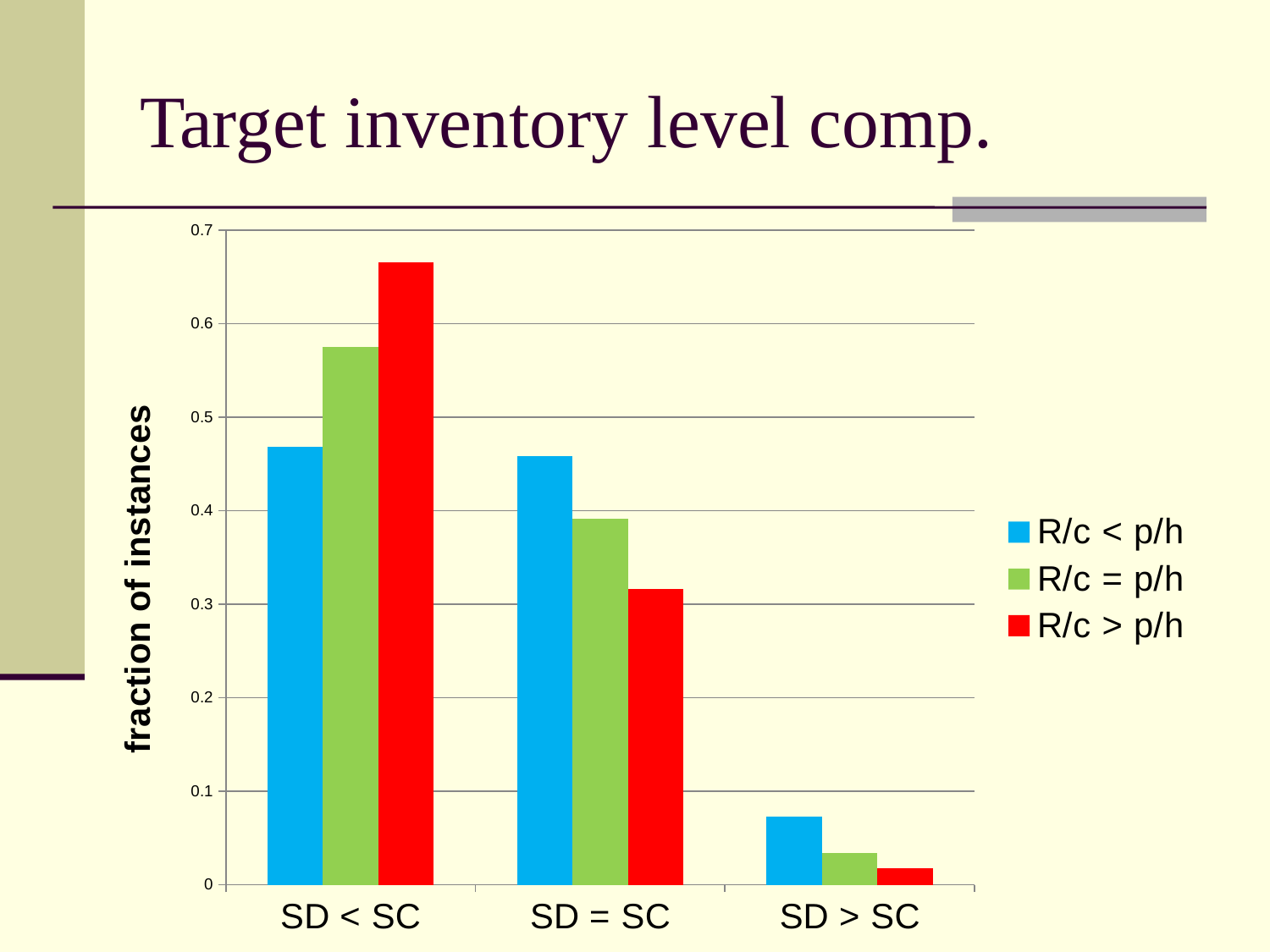
Which series has the highest bar in the SD = SC category? R/c < p/h Which series has the highest bar in the SD < SC category? R/c > p/h Is the value for R/c < p/h in the SD < SC category greater or less than 0.5? less How many series does the legend list? 3 Which series has the lowest bar in the SD > SC category? R/c > p/h Is the value for R/c > p/h in the SD < SC category greater or less than 0.6? greater Is the value for R/c < p/h in the SD > SC category greater or less than 0.1? less Do the values for the R/c > p/h series rise or fall from SD < SC to SD > SC? fall What kind of chart is shown on the slide? bar chart How many categories are shown on the x axis? 3 Which is larger for the R/c = p/h series: the value for SD < SC or the value for SD = SC? SD < SC